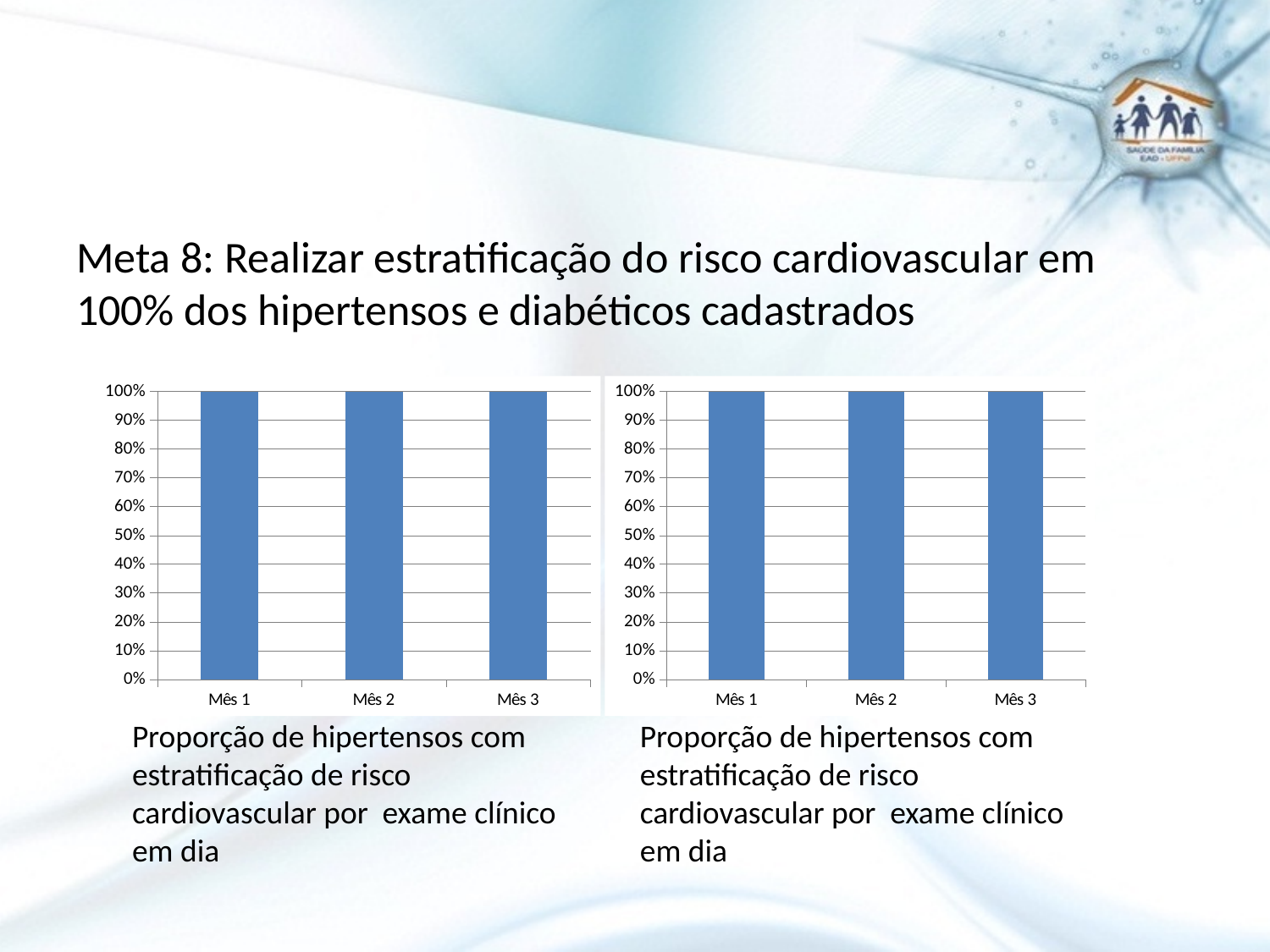
In the left chart, what is the value for Mês 1? 100% What is the label of the first category on the x axis of the left chart? Mês 1 What type of chart is the left chart on the slide? bar chart How many categories are shown on the x axis of the right chart? 3 In the right chart, do the values rise, fall, or stay the same from Mês 1 to Mês 3? stay the same In the right chart, what is the value for Mês 3? 100% In the left chart, is the value for Mês 3 greater or less than 90%? greater In the left chart, what is the difference between the values for Mês 1 and Mês 3? 0% In the left chart, what is the value for Mês 2? 100% How many categories are shown on the x axis of the left chart? 3 What is the highest value shown on the y axis of the right chart? 100% In the right chart, is the value for Mês 2 greater or less than 50%? greater